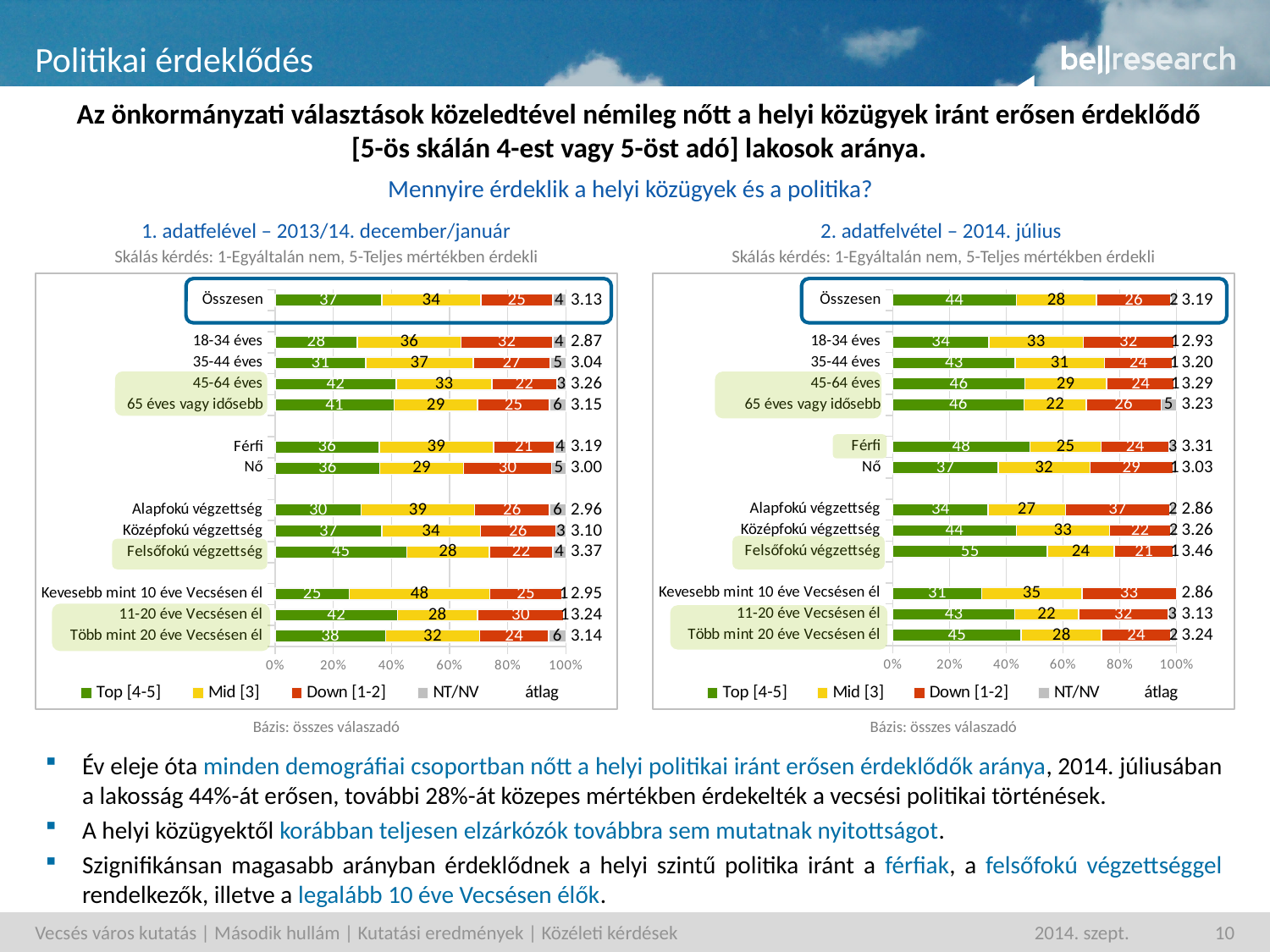
In the left chart (1. adatfelével – 2013/14. december/január), what is the Mid [3] value for Kevesebb mint 10 éve Vecsésen él? 48 In the right chart (2. adatfelvétel – 2014. július), what is the átlag value shown for Felsőfokú végzettség? 3.46 How many categories (bars) are shown in the right chart (2. adatfelvétel – 2014. július)? 13 In the left chart (1. adatfelével – 2013/14. december/január), which has the larger Down [1-2] value: 18-34 éves or 45-64 éves? 18-34 éves In the right chart (2. adatfelvétel – 2014. július), which category has the highest Top [4-5] value? Felsőfokú végzettség How many entries does the legend of the left chart (1. adatfelével – 2013/14. december/január) list? 5 In the left chart (1. adatfelével – 2013/14. december/január), which category has the lowest Top [4-5] value? Kevesebb mint 10 éve Vecsésen él In the right chart (2. adatfelvétel – 2014. július), what is the difference between the Top [4-5] values for Férfi and Nő? 11 In the right chart (2. adatfelvétel – 2014. július), what is the Top [4-5] value for Összesen? 44 What type of chart is the right chart (2. adatfelvétel – 2014. július)? Stacked bar chart In the left chart (1. adatfelével – 2013/14. december/január), what is the Top [4-5] value for Összesen? 37 In the left chart (1. adatfelével – 2013/14. december/január), what is the total of the Összesen bar (Top [4-5] + Mid [3] + Down [1-2] + NT/NV)? 100